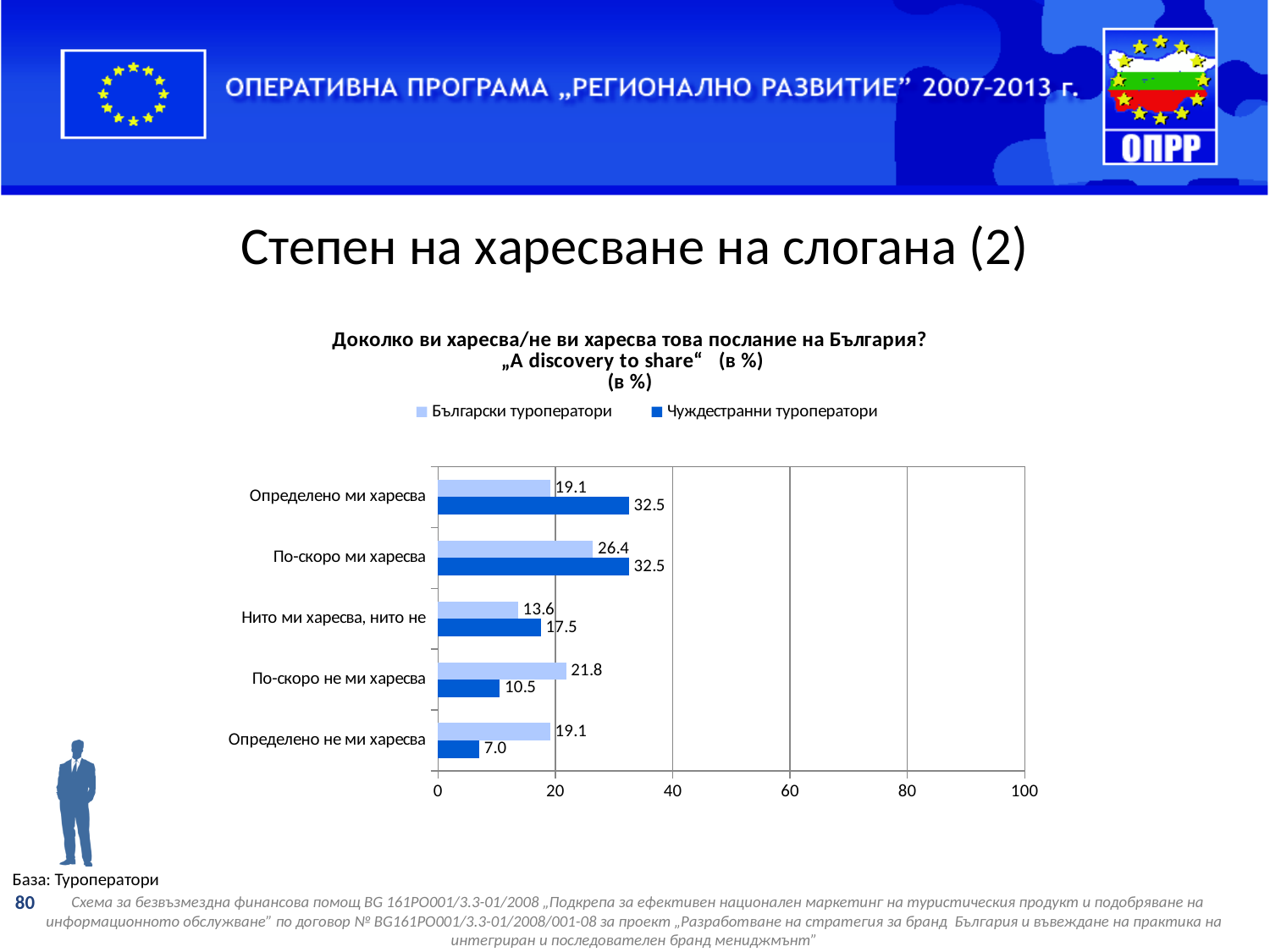
Which category has the highest value for Български туроператори? По-скоро ми харесва What is the value for Чуждестранни туроператори in the category Определено не ми харесва? 7.0 What is the value for Чуждестранни туроператори in the category Нито ми харесва, нито не? 17.5 How many series does the legend list? 2 How many categories are shown on the chart? 5 What is the difference between Чуждестранни туроператори and Български туроператори in the category Определено ми харесва? 13.4 What is the value for Български туроператори in the category По-скоро ми харесва? 26.4 What type of chart is shown on the slide? bar chart Which series is shown in dark blue in the legend? Чуждестранни туроператори Which category has the lowest value for Чуждестранни туроператори? Определено не ми харесва Is the value for Чуждестранни туроператори in the category По-скоро ми харесва greater or less than 40? less In the category По-скоро не ми харесва, which series has the larger value? Български туроператори